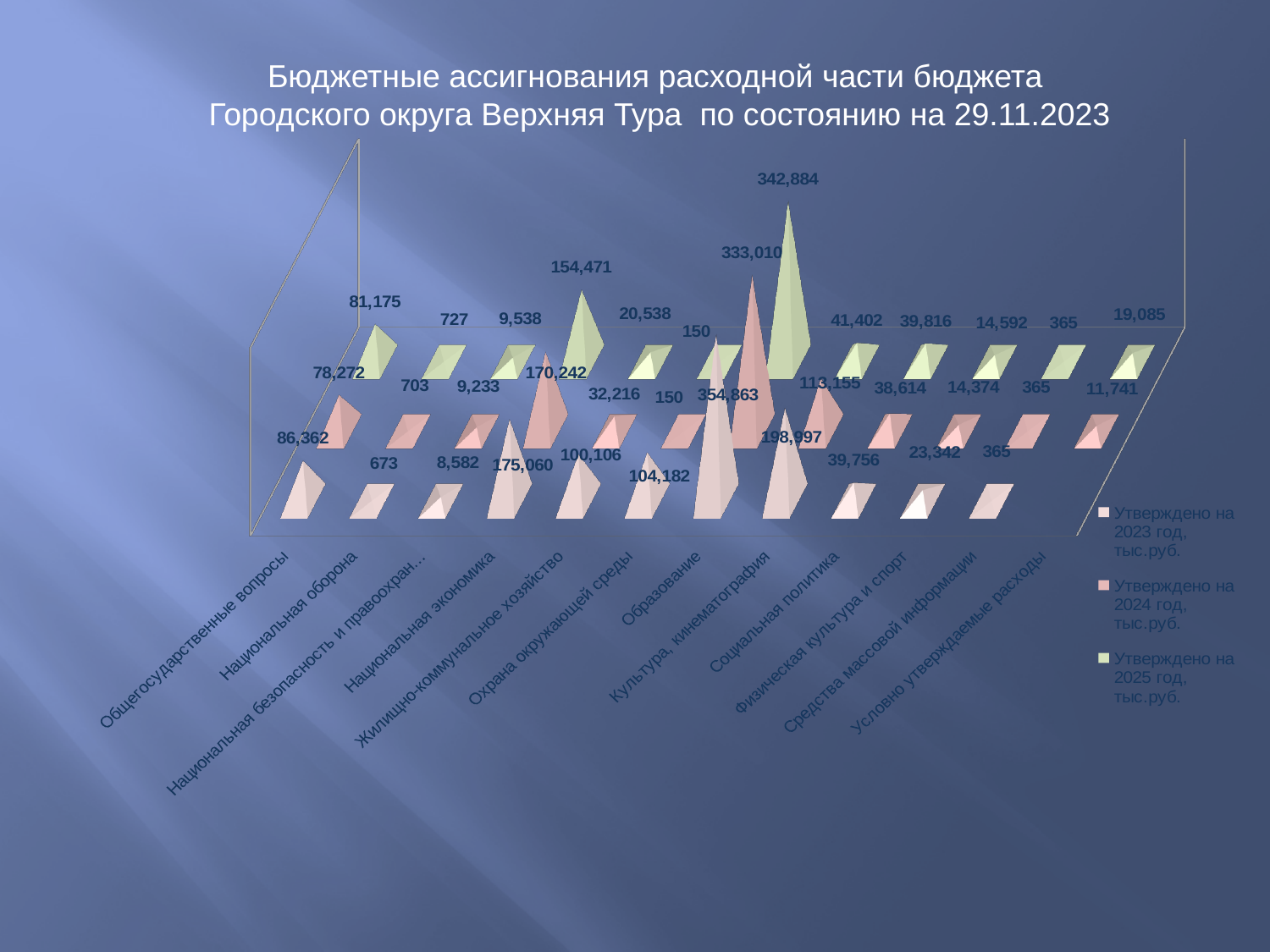
What is the value for Общегосударственные вопросы in the series Утверждено на 2023 год, тыс.руб.? 86,362 How many expenditure categories are shown along the x axis? 12 For Национальная экономика, which is larger: the value for Утверждено на 2023 год or for Утверждено на 2025 год? Утверждено на 2023 год What is the value for Условно утверждаемые расходы in the series Утверждено на 2025 год, тыс.руб.? 19,085 What is the difference between the 2023 and 2024 values for Общегосударственные вопросы? 8,090 What kind of chart is shown on the slide? bar chart What is the value for Общегосударственные вопросы in the series Утверждено на 2025 год, тыс.руб.? 81,175 How many series does the legend list? 3 What is the value for Национальная экономика in the series Утверждено на 2024 год, тыс.руб.? 170,242 What is the value for Национальная оборона in the series Утверждено на 2025 год, тыс.руб.? 727 Which category has the highest value in the series Утверждено на 2025 год, тыс.руб.? Образование What is the value for Жилищно-коммунальное хозяйство in the series Утверждено на 2023 год, тыс.руб.? 100,106